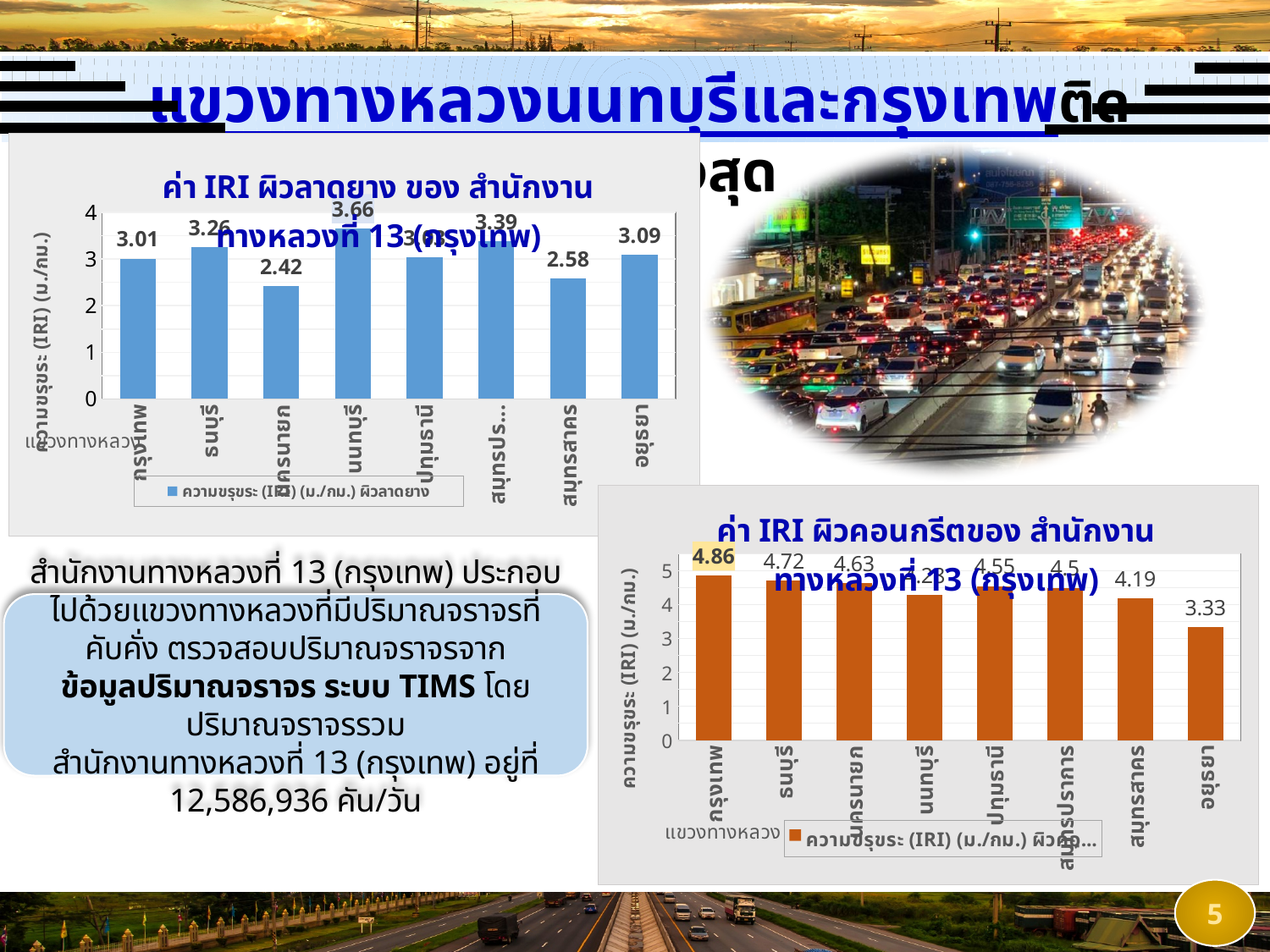
In the chart titled ค่า IRI ผิวคอนกรีต (bottom-right), is the value for อยุธยา greater or less than 4? less In the chart titled ค่า IRI ผิวลาดยาง (top-left), which highway district has the lowest IRI value? นครนายก In the chart titled ค่า IRI ผิวลาดยาง (top-left), is the value for สมุทรสาคร greater or less than 3? less In the chart titled ค่า IRI ผิวลาดยาง (top-left), how many highway districts are plotted? 8 In the chart titled ค่า IRI ผิวคอนกรีต (bottom-right), which is larger, the value for ธนบุรี or for นครนายก? ธนบุรี What type of chart is the chart titled ค่า IRI ผิวคอนกรีต (bottom-right)? bar chart In the chart titled ค่า IRI ผิวคอนกรีต (bottom-right), what is the IRI value for กรุงเทพ? 4.86 In the chart titled ค่า IRI ผิวลาดยาง (top-left), which highway district has the highest IRI value? นนทบุรี In the chart titled ค่า IRI ผิวลาดยาง (top-left), what is the difference between the values for กรุงเทพ and นครนายก? 0.59 In the chart titled ค่า IRI ผิวคอนกรีต (bottom-right), what is the difference between the values for สมุทรสาคร and อยุธยา? 0.86 In the chart titled ค่า IRI ผิวลาดยาง (top-left), what is the IRI value for นนทบุรี? 3.66 In the chart titled ค่า IRI ผิวคอนกรีต (bottom-right), which highway district has the lowest IRI value? อยุธยา